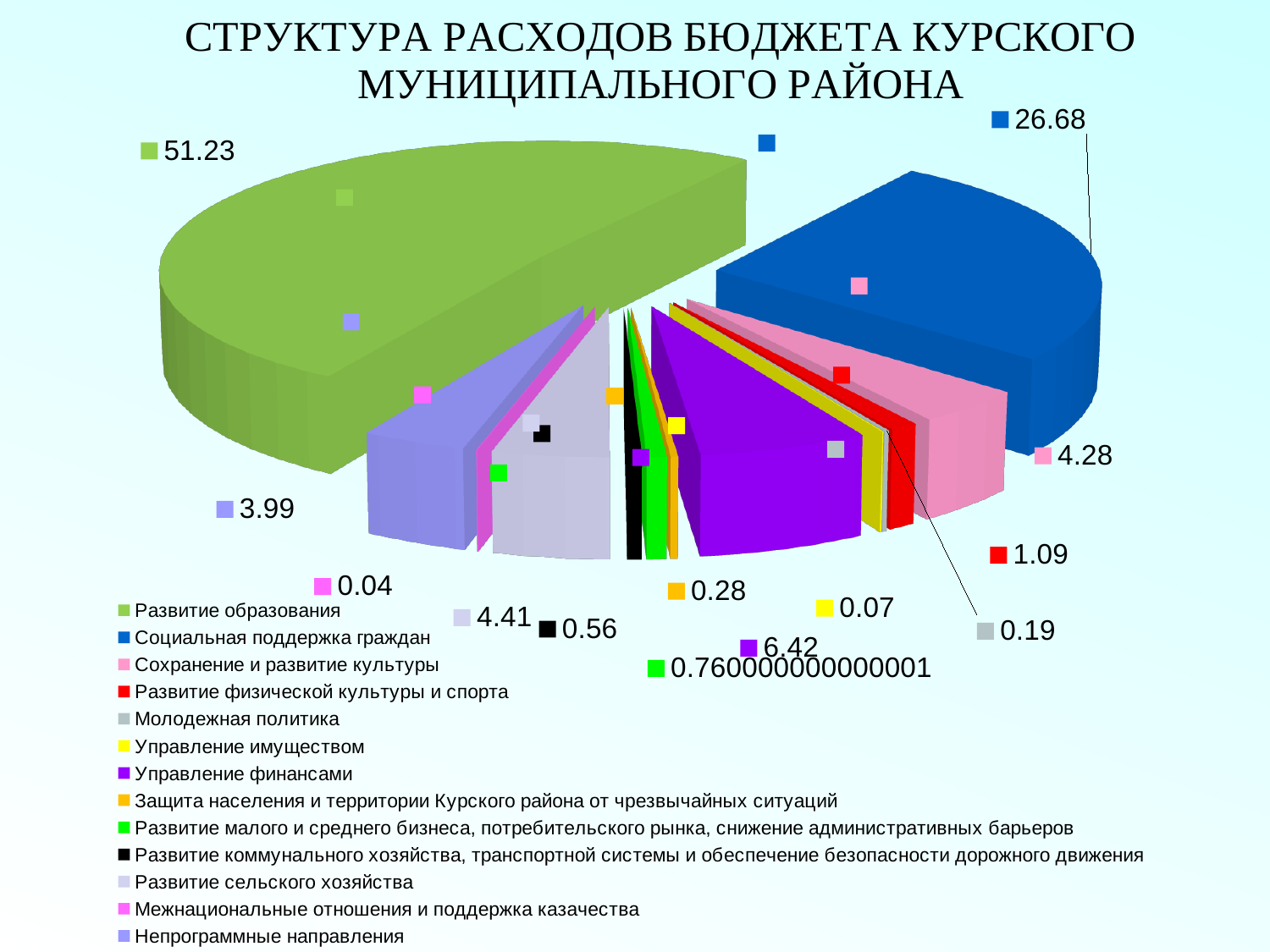
What is the difference between the values for Развитие образования and Социальная поддержка граждан? 24.55 What kind of chart is shown on the slide? pie chart What is the value for Развитие образования? 51.23 What is the title of the chart? СТРУКТУРА РАСХОДОВ БЮДЖЕТА КУРСКОГО МУНИЦИПАЛЬНОГО РАЙОНА Which is larger, the value for Развитие сельского хозяйства or the value for Сохранение и развитие культуры? Развитие сельского хозяйства What is the value for Социальная поддержка граждан? 26.68 How many categories does the legend list? 13 Which category has the largest slice of the pie? Развитие образования What is the value for Непрограммные направления? 3.99 Which category has the smallest value? Межнациональные отношения и поддержка казачества What is the value for Управление финансами? 6.42 What is the value for Сохранение и развитие культуры? 4.28